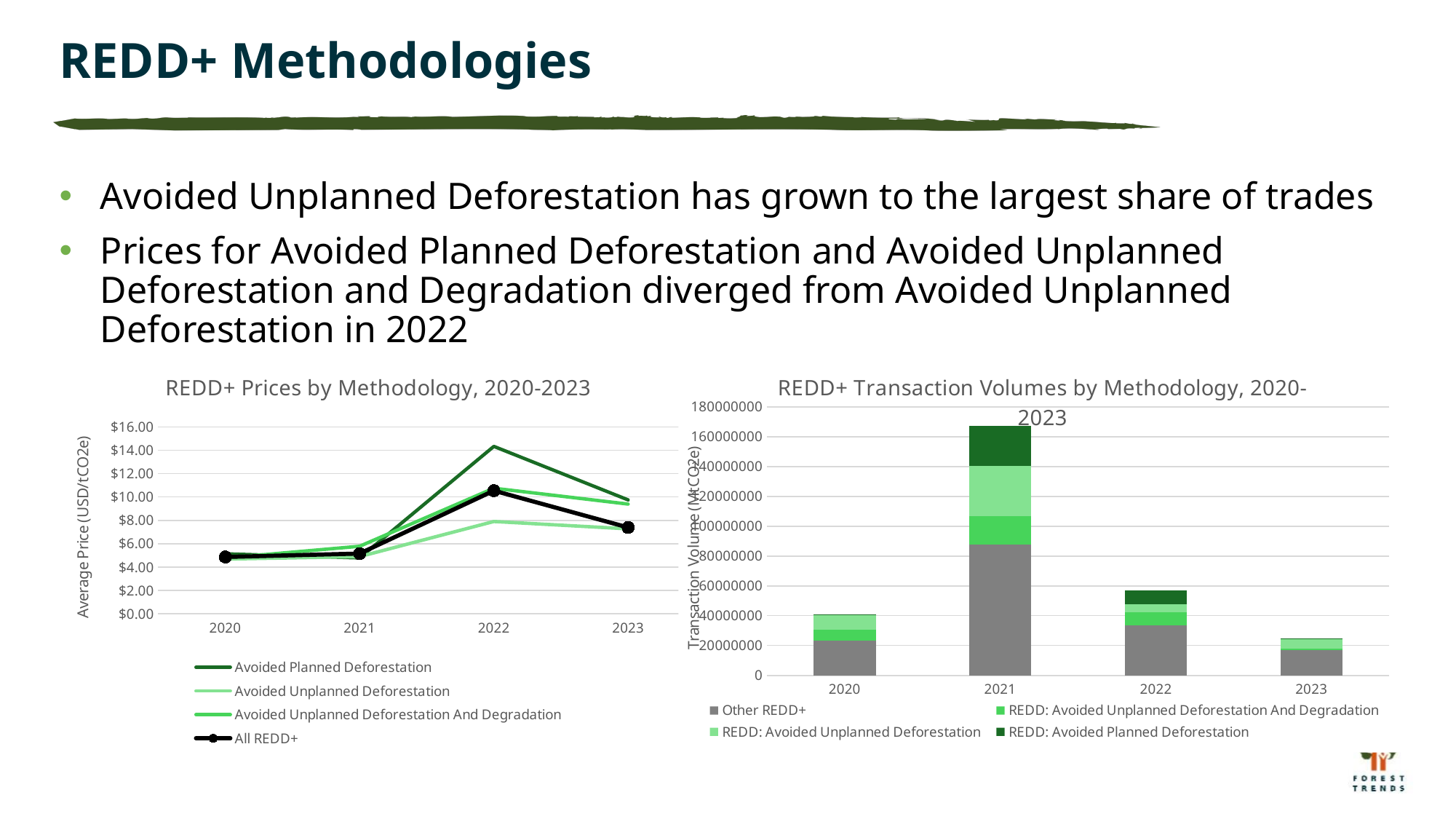
In the 'REDD+ Transaction Volumes by Methodology, 2020-2023' chart, is the total volume for 2021 greater or less than 140000000? greater In the 'REDD+ Prices by Methodology, 2020-2023' chart, how many series does the legend list? 4 In the 'REDD+ Prices by Methodology, 2020-2023' chart, does the Avoided Planned Deforestation price rise or fall from 2022 to 2023? fall In the 'REDD+ Prices by Methodology, 2020-2023' chart, is the 2020 price for All REDD+ greater or less than $6.00? less In the 'REDD+ Prices by Methodology, 2020-2023' chart, which methodology has the lowest price in 2022? Avoided Unplanned Deforestation In the 'REDD+ Prices by Methodology, 2020-2023' chart, is the 2022 price for Avoided Planned Deforestation greater or less than $12.00? greater In the 'REDD+ Transaction Volumes by Methodology, 2020-2023' chart, which year has the tallest stacked bar? 2021 In the 'REDD+ Transaction Volumes by Methodology, 2020-2023' chart, how many years are shown on the x axis? 4 What type of chart is the 'REDD+ Transaction Volumes by Methodology, 2020-2023' chart? stacked bar chart What type of chart is the 'REDD+ Prices by Methodology, 2020-2023' chart? line chart In the 'REDD+ Transaction Volumes by Methodology, 2020-2023' chart, which year has a larger total volume, 2020 or 2022? 2022 In the 'REDD+ Prices by Methodology, 2020-2023' chart, which methodology has the highest price in 2022? Avoided Planned Deforestation